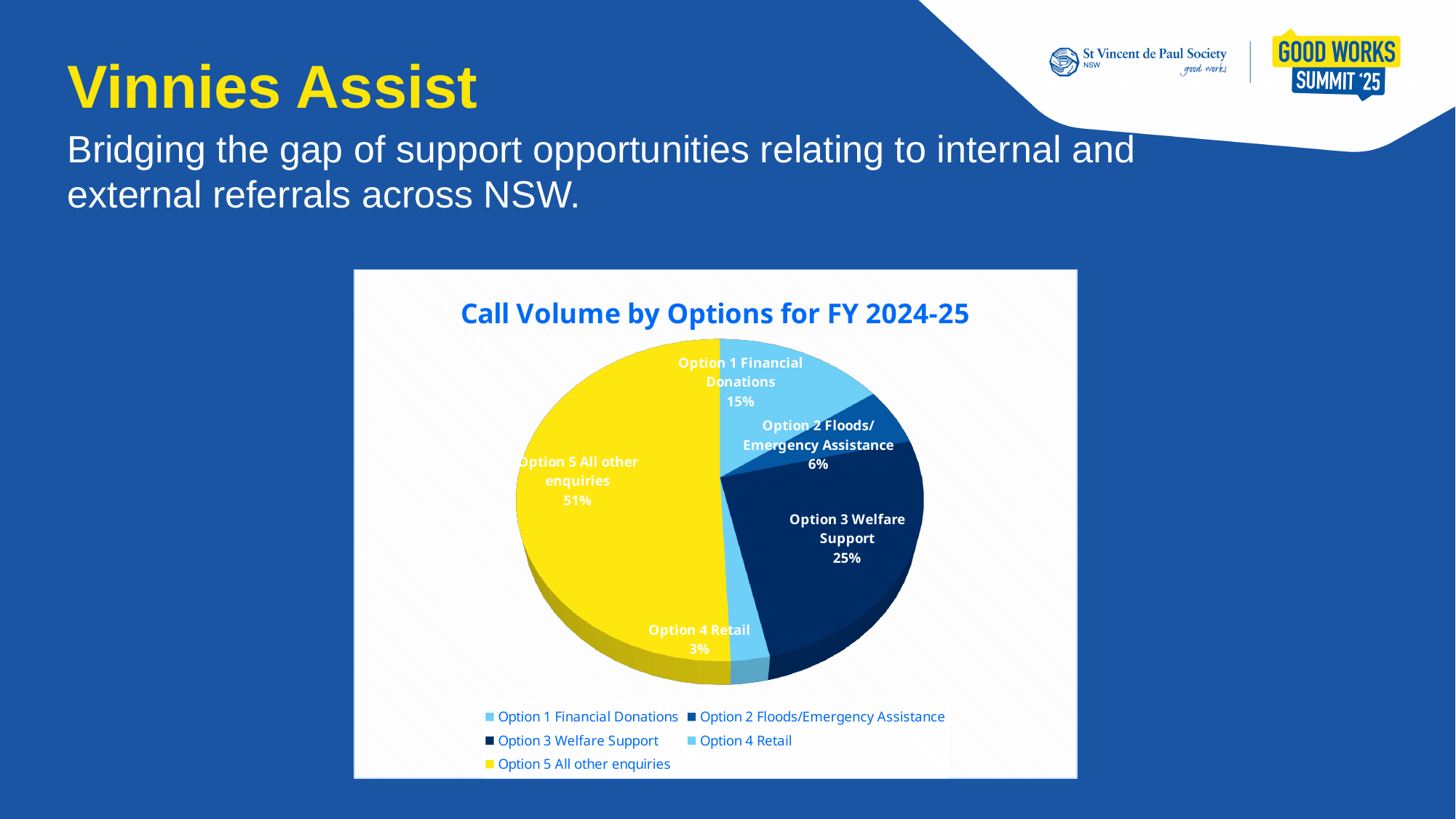
What is the title of the chart? Call Volume by Options for FY 2024-25 What share of call volume is Option 2 Floods/Emergency Assistance? 6% Which option has the largest share of call volume? Option 5 All other enquiries What kind of chart is shown on the slide? Pie chart What is the difference in percentage points between Option 5 All other enquiries and Option 3 Welfare Support? 26 What share of call volume is Option 4 Retail? 3% What share of call volume is Option 3 Welfare Support? 25% How many slices does the pie chart have? 5 Which has a larger share, Option 1 Financial Donations or Option 2 Floods/Emergency Assistance? Option 1 Financial Donations Which option has the smallest share of call volume? Option 4 Retail What colour is the slice for Option 5 All other enquiries? Yellow What share of call volume is Option 1 Financial Donations? 15%